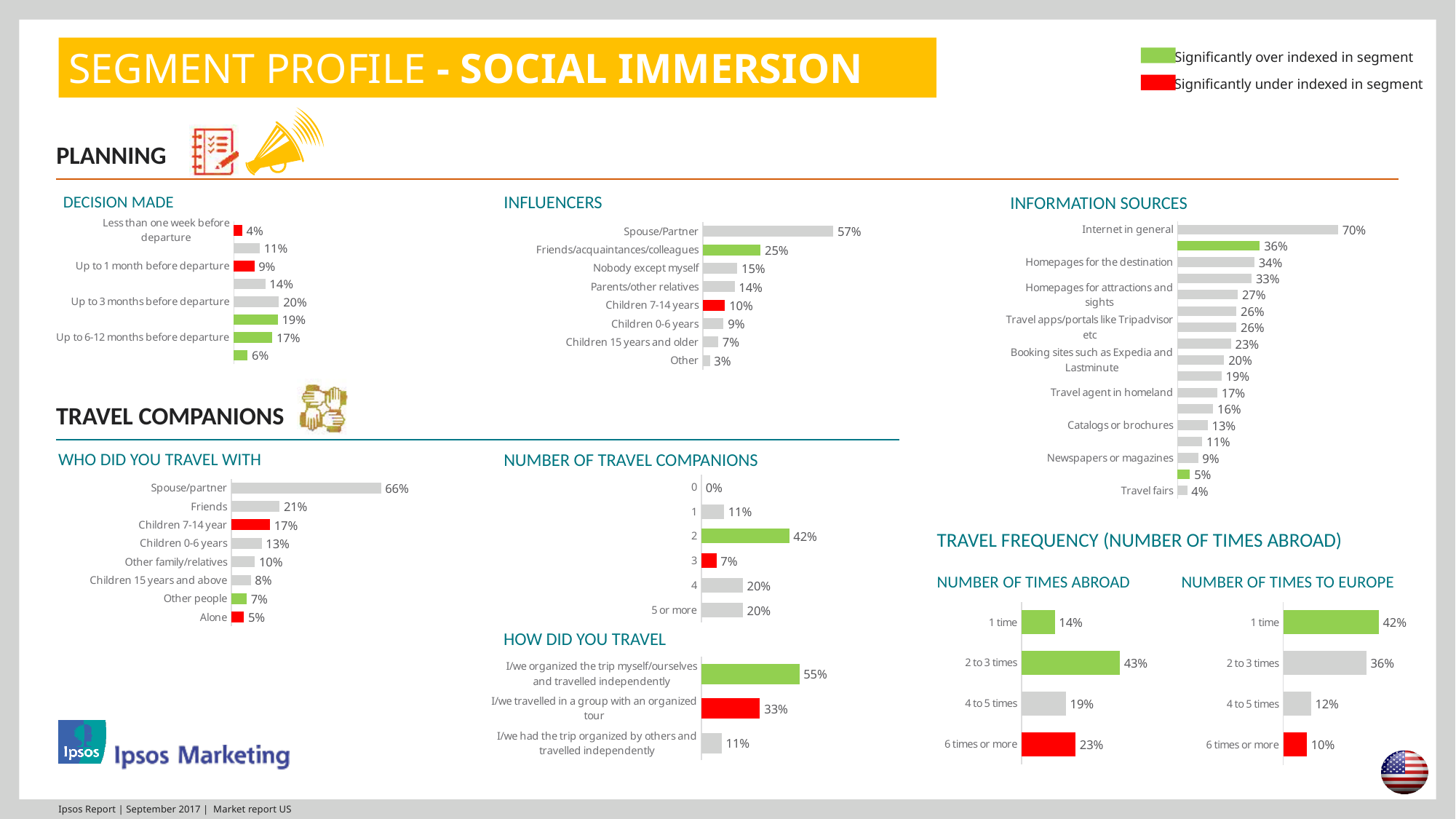
In the NUMBER OF TIMES ABROAD chart, what is the value for 6 times or more? 23% In the INFORMATION SOURCES chart, what is the value for Internet in general? 70% In the INFLUENCERS chart, which category has the highest value? Spouse/Partner In the NUMBER OF TIMES TO EUROPE chart, which is larger: 1 time or 2 to 3 times? 1 time In the INFLUENCERS chart, what is the value for Spouse/Partner? 57% In the NUMBER OF TRAVEL COMPANIONS chart, what is the value for 2 companions? 42% In the WHO DID YOU TRAVEL WITH chart, what is the difference between the values for Spouse/partner and Friends? 45% In the NUMBER OF TIMES ABROAD chart, which category has the highest value? 2 to 3 times What kind of chart is the WHO DID YOU TRAVEL WITH chart? Bar chart In the INFLUENCERS chart, which category has the lowest value? Other According to the legend at the top right of the slide, what does a green bar indicate? Significantly over indexed in segment How many categories are shown in the HOW DID YOU TRAVEL chart? 3